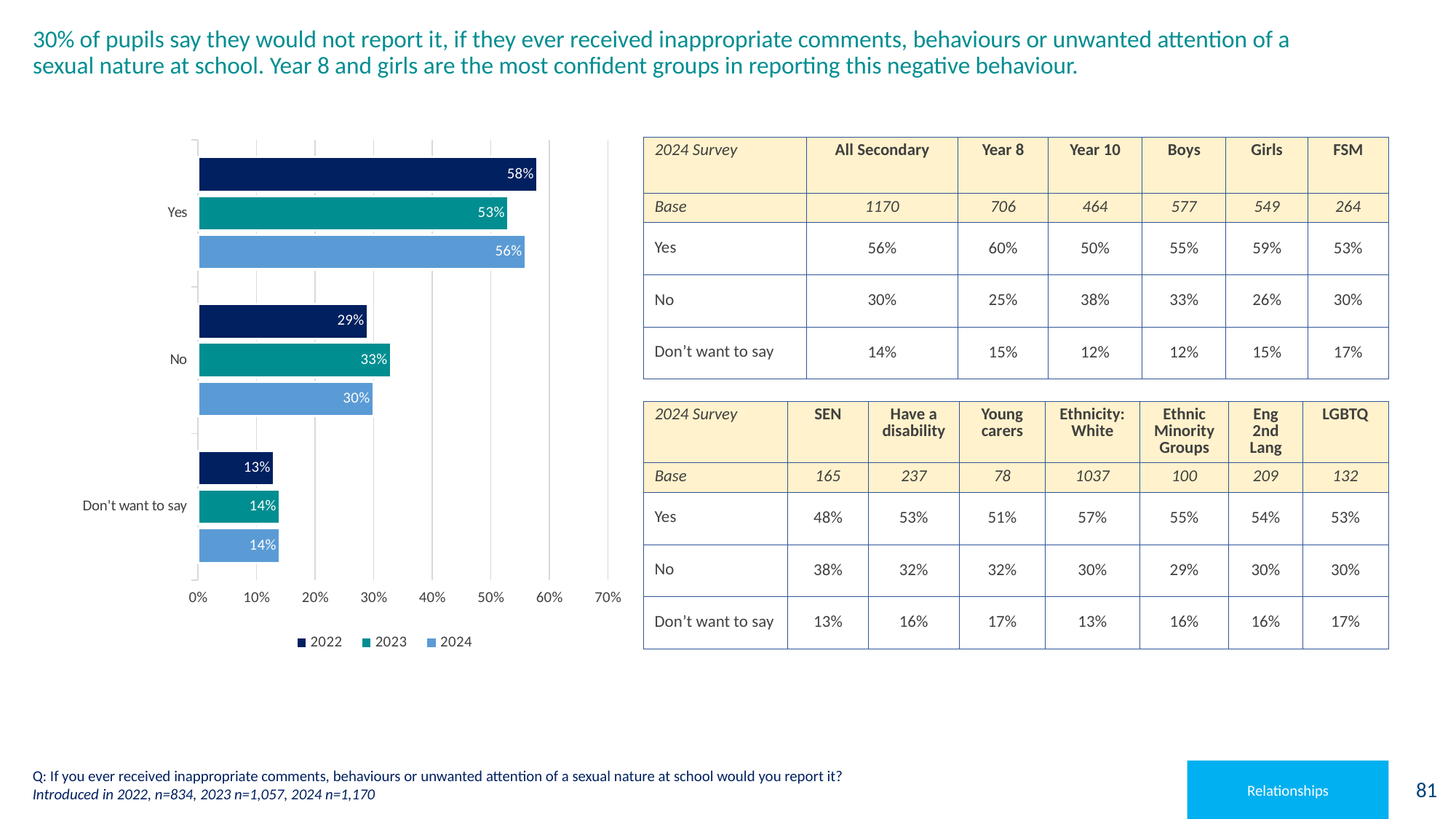
Which category has the highest value in the 2024 series? Yes Which series is shown in the darkest blue colour in the legend? 2022 Which category has the lowest value in the 2022 series? Don't want to say What is the value for 'No' in the 2023 series? 33% Is the 2024 value for 'Yes' greater or less than 50%? greater What is the value for 'Don't want to say' in the 2024 series? 14% Which is larger: the 2023 value for 'No' or the 2024 value for 'No'? 2023 How many series does the legend list? 3 How many categories are shown on the chart? 3 What kind of chart is shown on the slide? bar chart What is the value for 'Yes' in the 2022 series? 58% What is the difference between the 2022 and 2023 values for 'Yes'? 5%